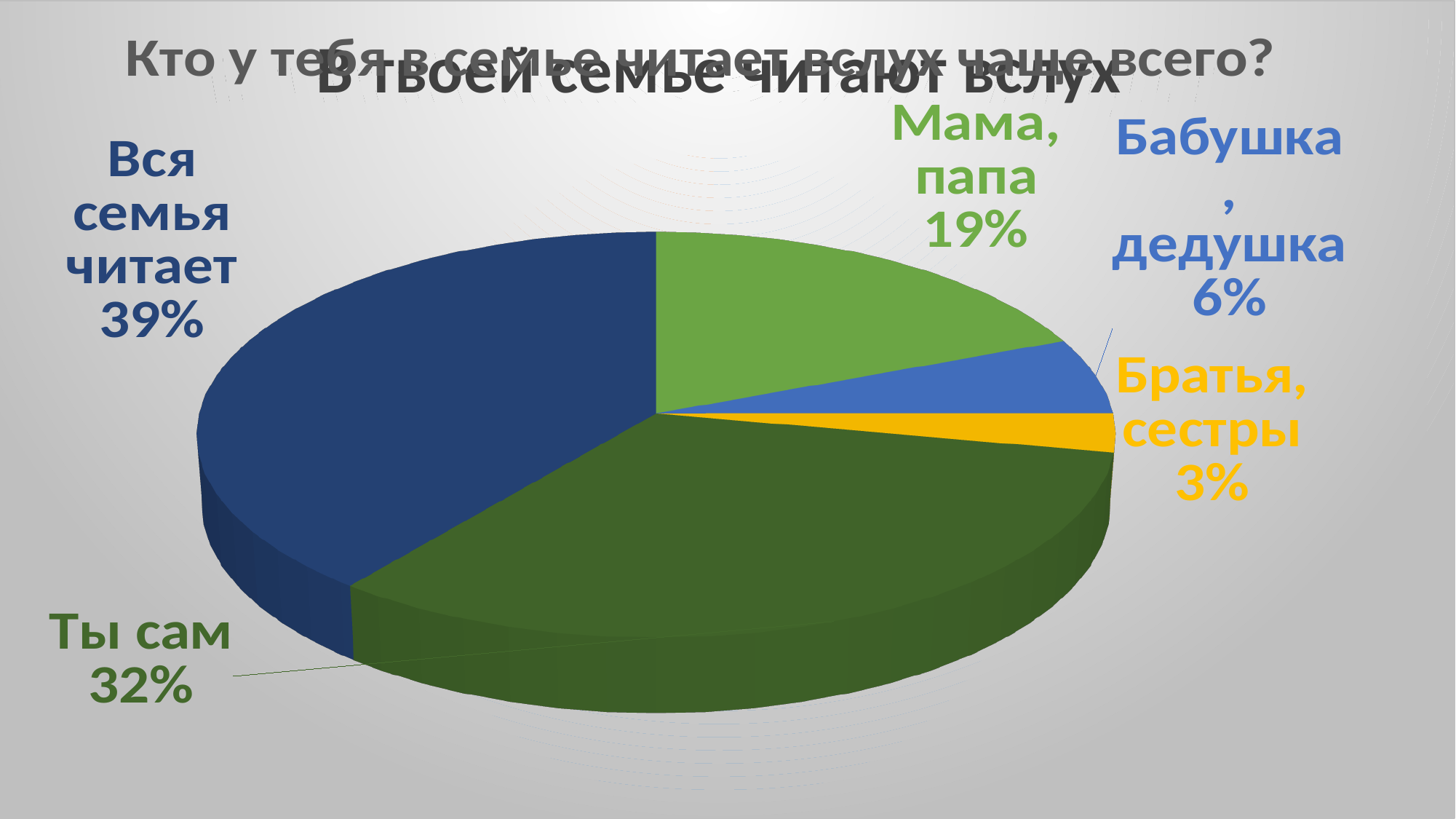
What is the value shown for "Мама, папа"? 19% Which category has the largest slice of the pie? Вся семья читает How many slices does the pie chart have? 5 What is the value shown for "Бабушка, дедушка"? 6% Which is larger, the slice for "Мама, папа" or the slice for "Бабушка, дедушка"? Мама, папа Which category has the smallest slice of the pie? Братья, сестры What type of chart is shown on the slide? pie chart What colour is the slice for "Братья, сестры"? yellow What is the difference in percentage points between "Вся семья читает" and "Ты сам"? 7 What is the value shown for "Братья, сестры"? 3% What share of the pie does "Вся семья читает" have? 39% What is the value shown for "Ты сам"? 32%